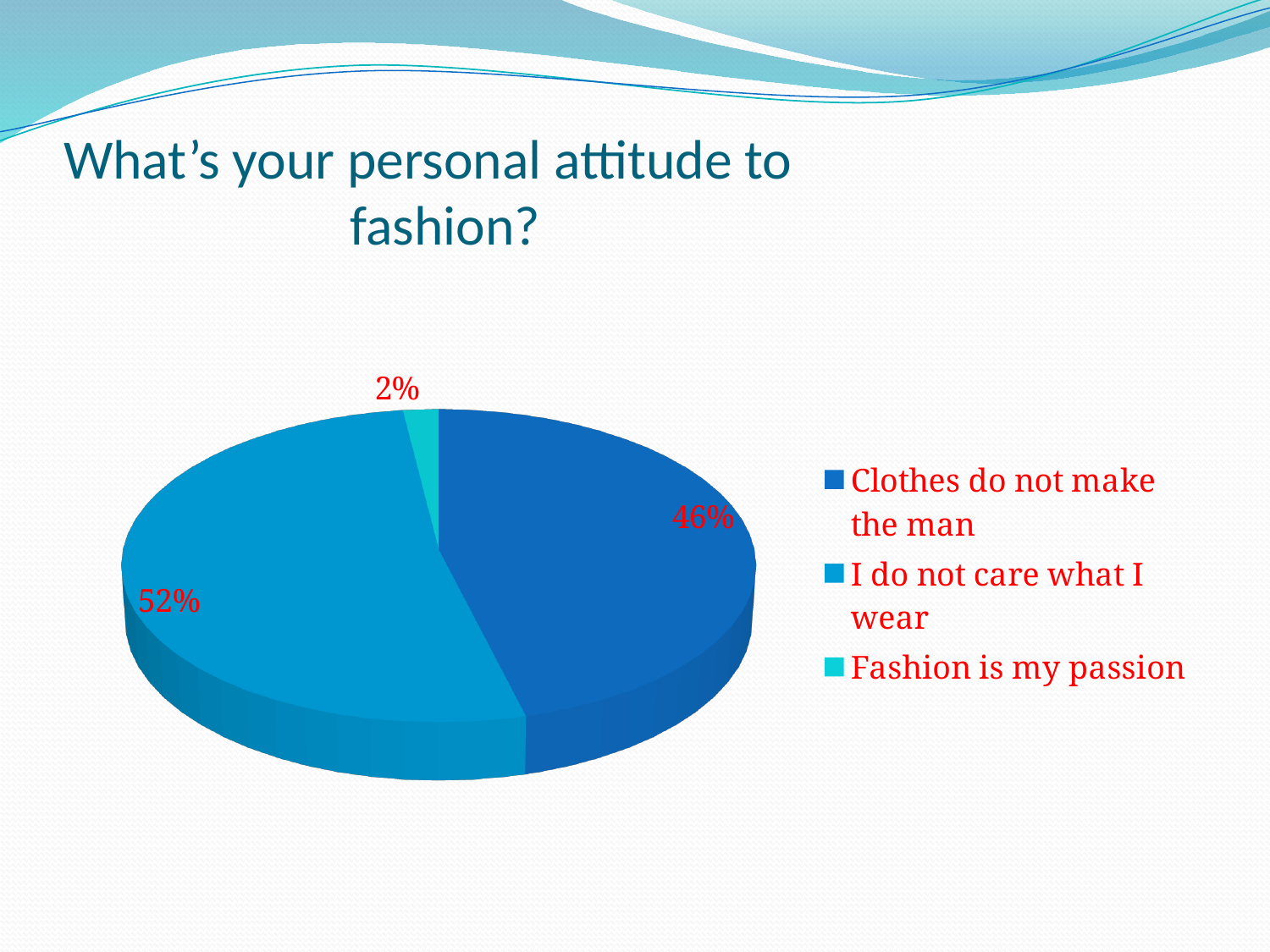
What share of the pie is labelled "Clothes do not make the man"? 46% How many slices does the pie chart have? 3 What is the combined share of "Clothes do not make the man" and "I do not care what I wear"? 98% Which category has the largest slice of the pie? I do not care what I wear What share of the pie is labelled "I do not care what I wear"? 52% What is the title of the slide containing the chart? What's your personal attitude to fashion? What is the difference in percentage points between "I do not care what I wear" and "Clothes do not make the man"? 6 What share of the pie is labelled "Fashion is my passion"? 2% Which category has the smallest slice of the pie? Fashion is my passion How many entries does the chart legend list? 3 What kind of chart is shown on the slide? Pie chart Which is larger: the slice for "Clothes do not make the man" or the slice for "Fashion is my passion"? Clothes do not make the man